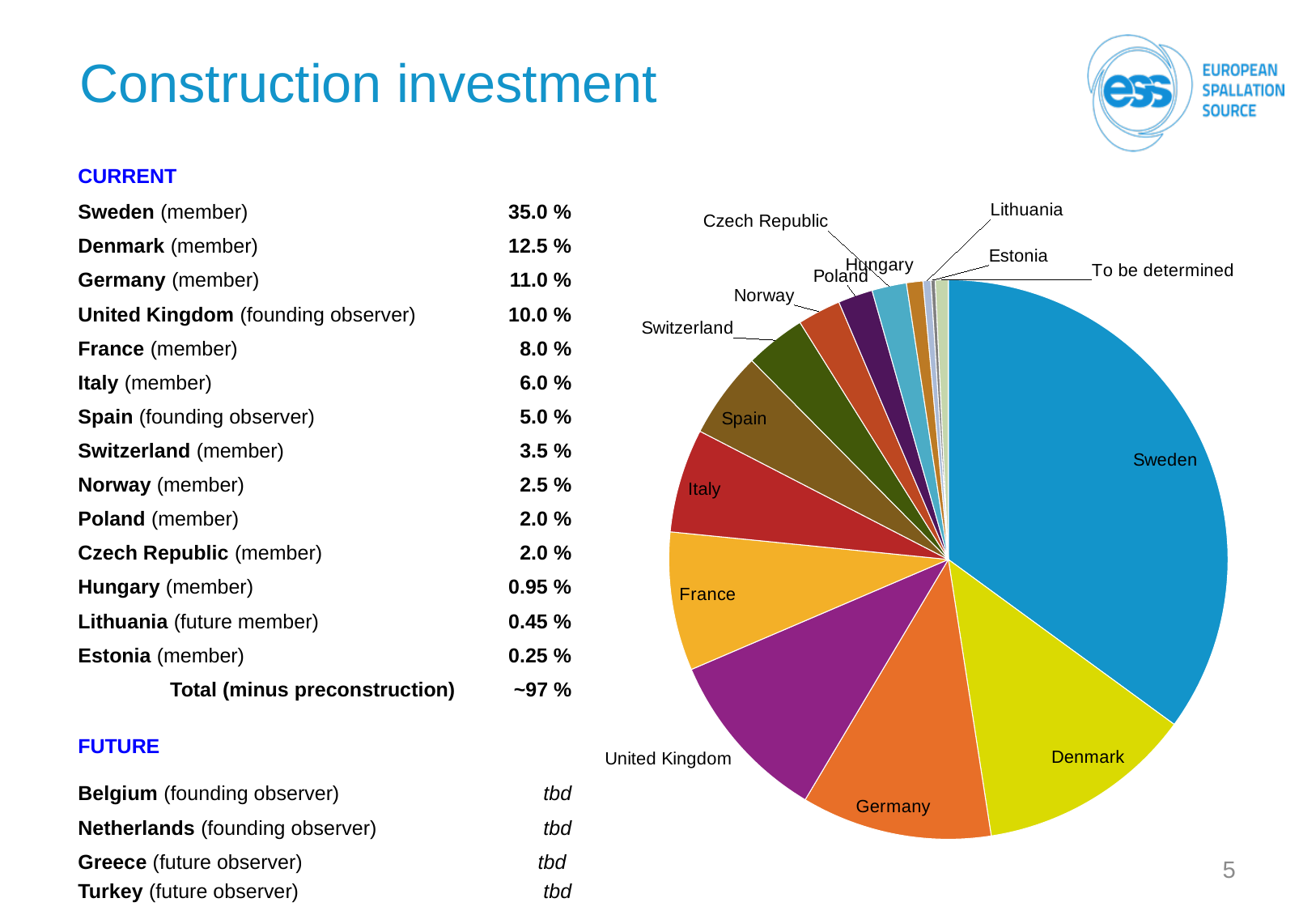
What share of construction investment does Sweden contribute? 35.0 % Which of the named countries has the smallest share in the pie chart? Estonia What is the difference between Italy's share and Spain's share? 1.0 % What kind of chart is shown on the slide? pie chart What share of construction investment does the United Kingdom contribute? 10.0 % How many slices does the pie chart have, including 'To be determined'? 15 What share of construction investment does Denmark contribute? 12.5 % Which slice is larger, Germany or France? Germany Which country has the largest slice of the pie chart? Sweden Which slice is larger, Switzerland or Norway? Switzerland What is the difference between Sweden's share and Denmark's share? 22.5 % What share of construction investment does Estonia contribute? 0.25 %